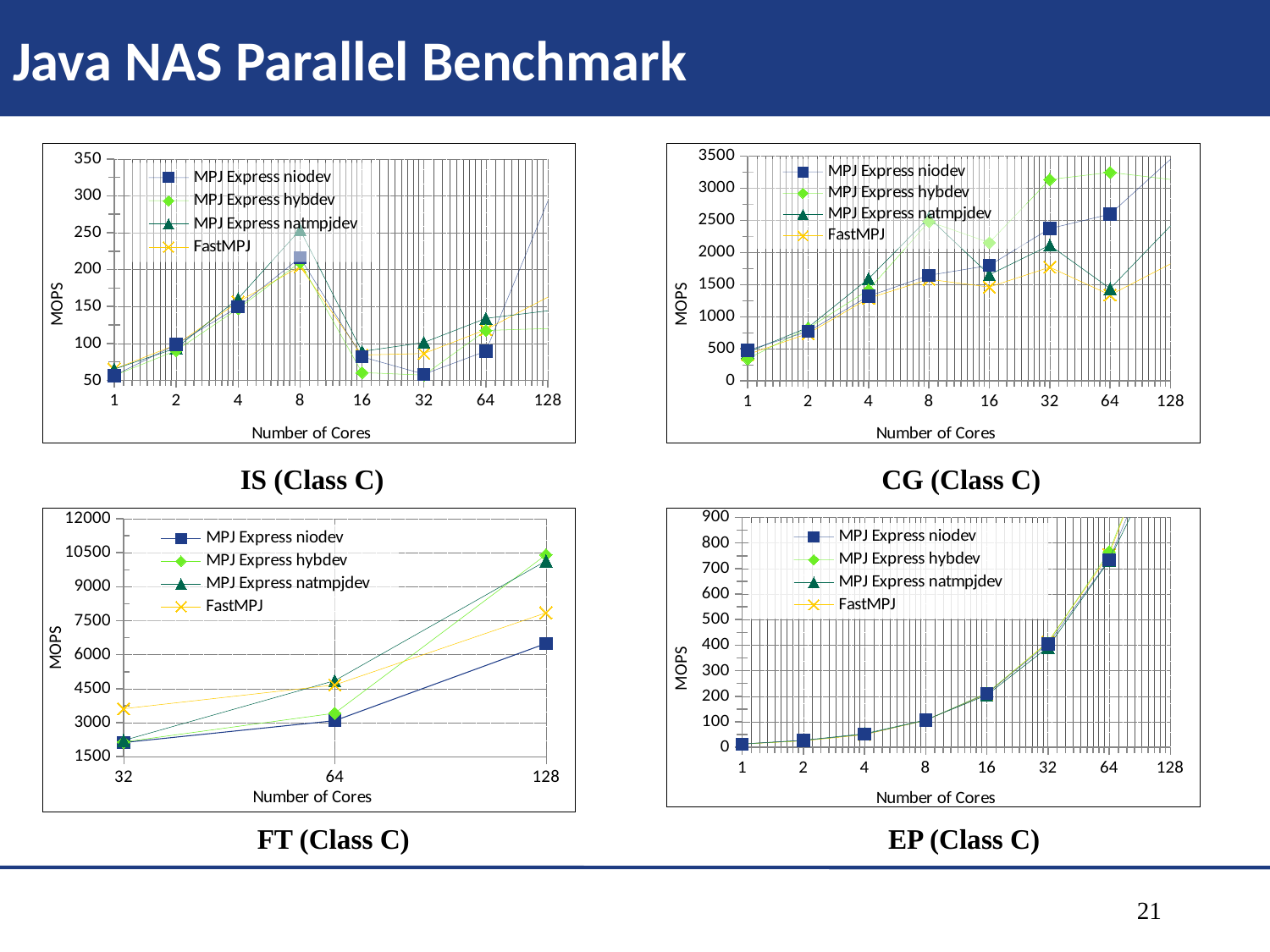
In the FT (Class C) chart, which series has the lowest value at 128 cores? MPJ Express niodev In the IS (Class C) chart, is the value for MPJ Express niodev at 8 cores greater or less than 200? greater In the CG (Class C) chart, is the value for MPJ Express hybdev at 64 cores greater or less than 3000? greater What is the label of the y axis on the EP (Class C) chart? MOPS What kind of chart is the IS (Class C) chart? line chart In the CG (Class C) chart, which is larger at 64 cores: MPJ Express hybdev or MPJ Express niodev? MPJ Express hybdev In the EP (Class C) chart, do the values rise or fall as the number of cores increases? rise In the FT (Class C) chart, is the value for MPJ Express niodev at 128 cores greater or less than 7500? less How many core counts are plotted along the x axis of the EP (Class C) chart? 8 How many series does the legend of the CG (Class C) chart list? 4 How many core counts are plotted along the x axis of the FT (Class C) chart? 3